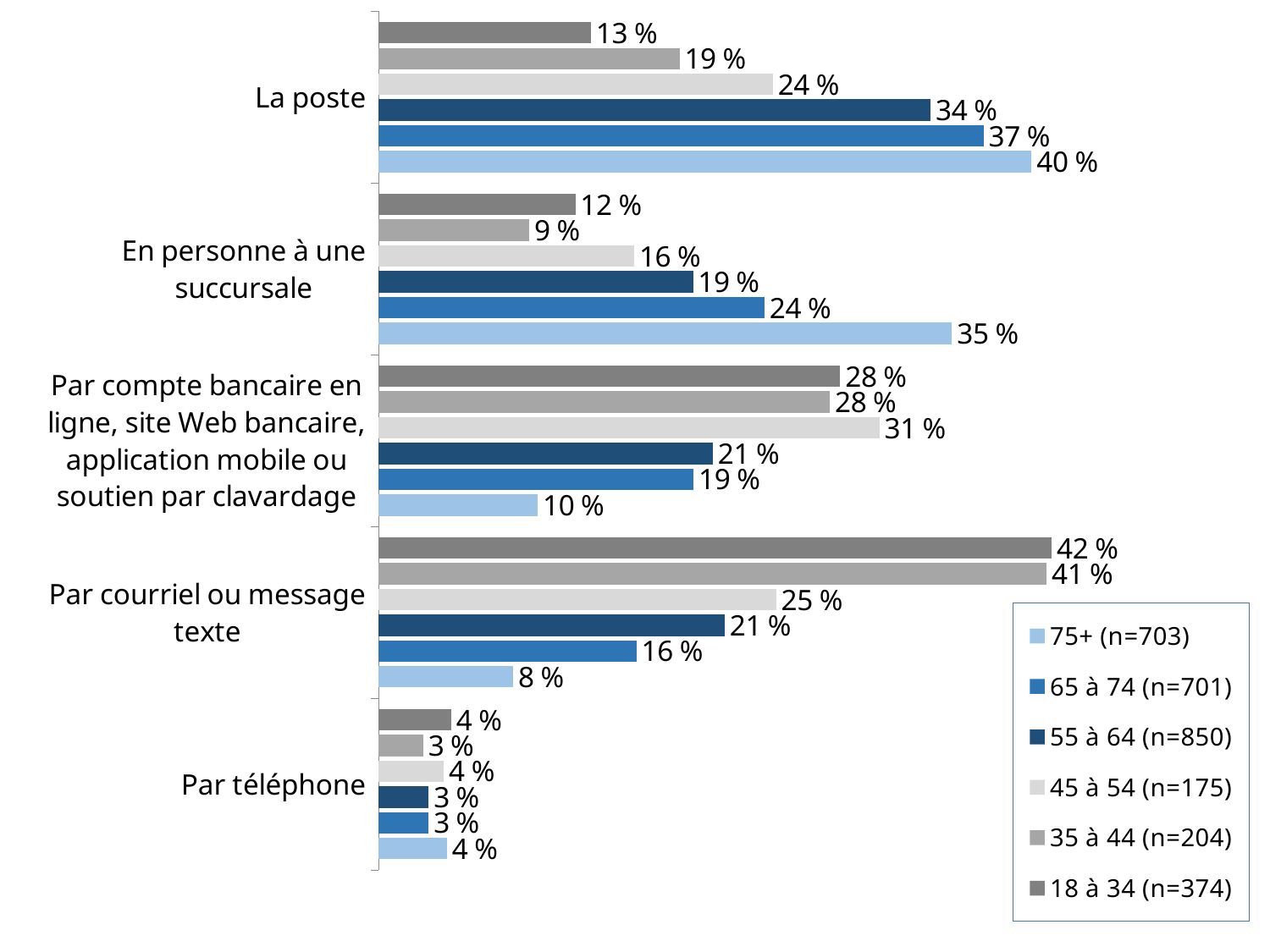
What is the value for the 75+ (n=703) group for "La poste"? 40 % What is the difference between the 75+ (n=703) and 18 à 34 (n=374) values for "La poste"? 27 % What is the sample size (n) shown in the legend for the 55 à 64 group? 850 Which age group has the lowest value for "Par courriel ou message texte"? 75+ (n=703) What is the value for the 45 à 54 (n=175) group for "Par compte bancaire en ligne, site Web bancaire, application mobile ou soutien par clavardage"? 31 % How many categories (contact methods) are shown on the chart? 5 How many series does the legend list? 6 What kind of chart is shown on the slide? Bar chart Which age group has the highest value for "En personne à une succursale"? 75+ (n=703) What is the value for the 65 à 74 (n=701) group for "En personne à une succursale"? 24 % What is the value for the 18 à 34 (n=374) group for "Par courriel ou message texte"? 42 % For "Par compte bancaire en ligne, site Web bancaire, application mobile ou soutien par clavardage", which is larger: the value for 55 à 64 (n=850) or for 75+ (n=703)? 55 à 64 (n=850)